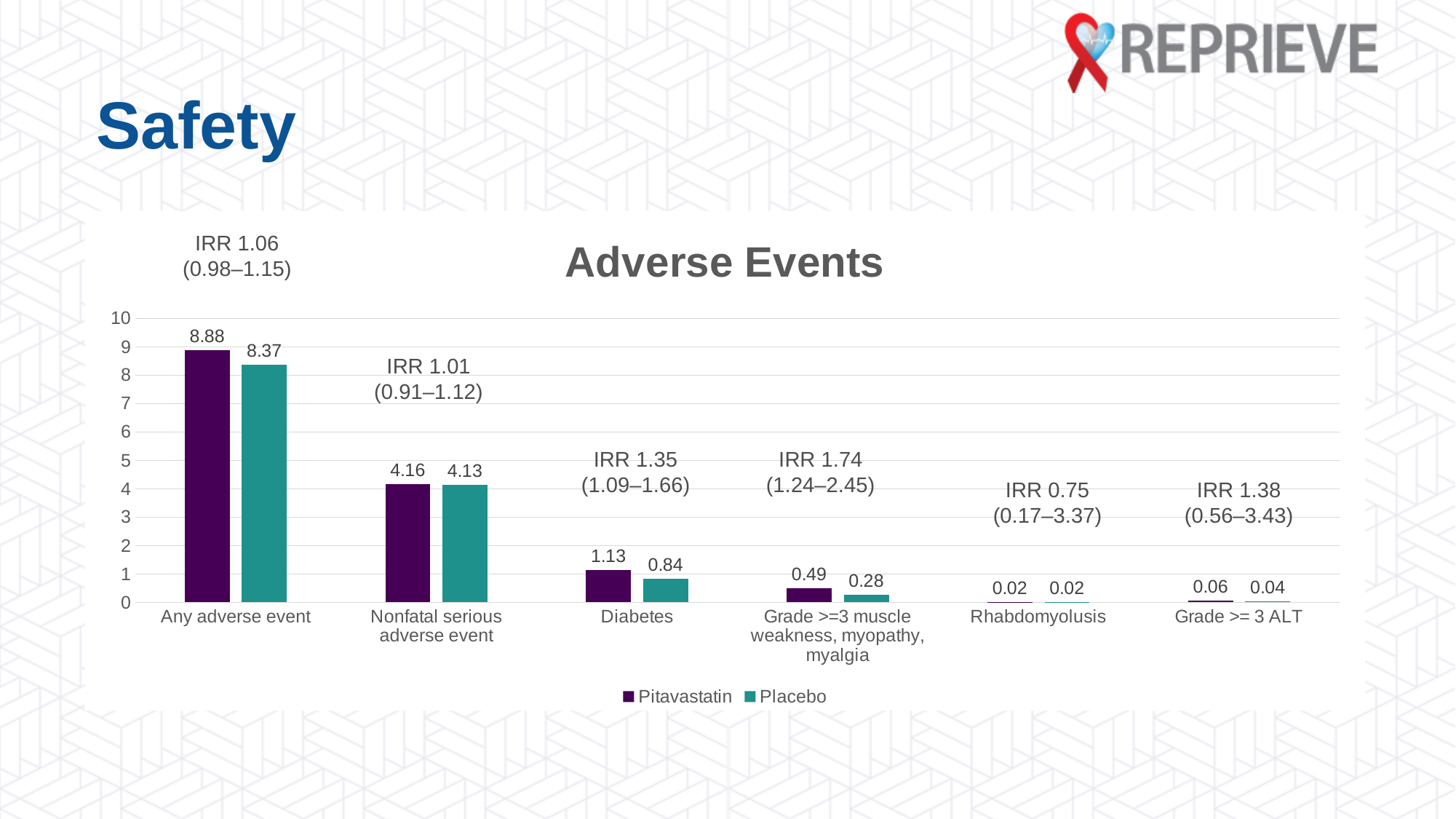
Which is larger for Diabetes, the Pitavastatin value or the Placebo value? Pitavastatin What kind of chart is shown? Bar chart Which category has the lowest Placebo value? Rhabdomyolysis What is the Pitavastatin value for Any adverse event? 8.88 What is the Placebo value for Grade >= 3 ALT? 0.04 Which category has the highest Pitavastatin value? Any adverse event What is the Placebo value for Diabetes? 0.84 What is the difference between the Pitavastatin and Placebo values for Any adverse event? 0.51 What is the Pitavastatin value for Grade >=3 muscle weakness, myopathy, myalgia? 0.49 What is the title of the chart? Adverse Events How many series does the legend list? 2 How many categories are shown on the x axis? 6